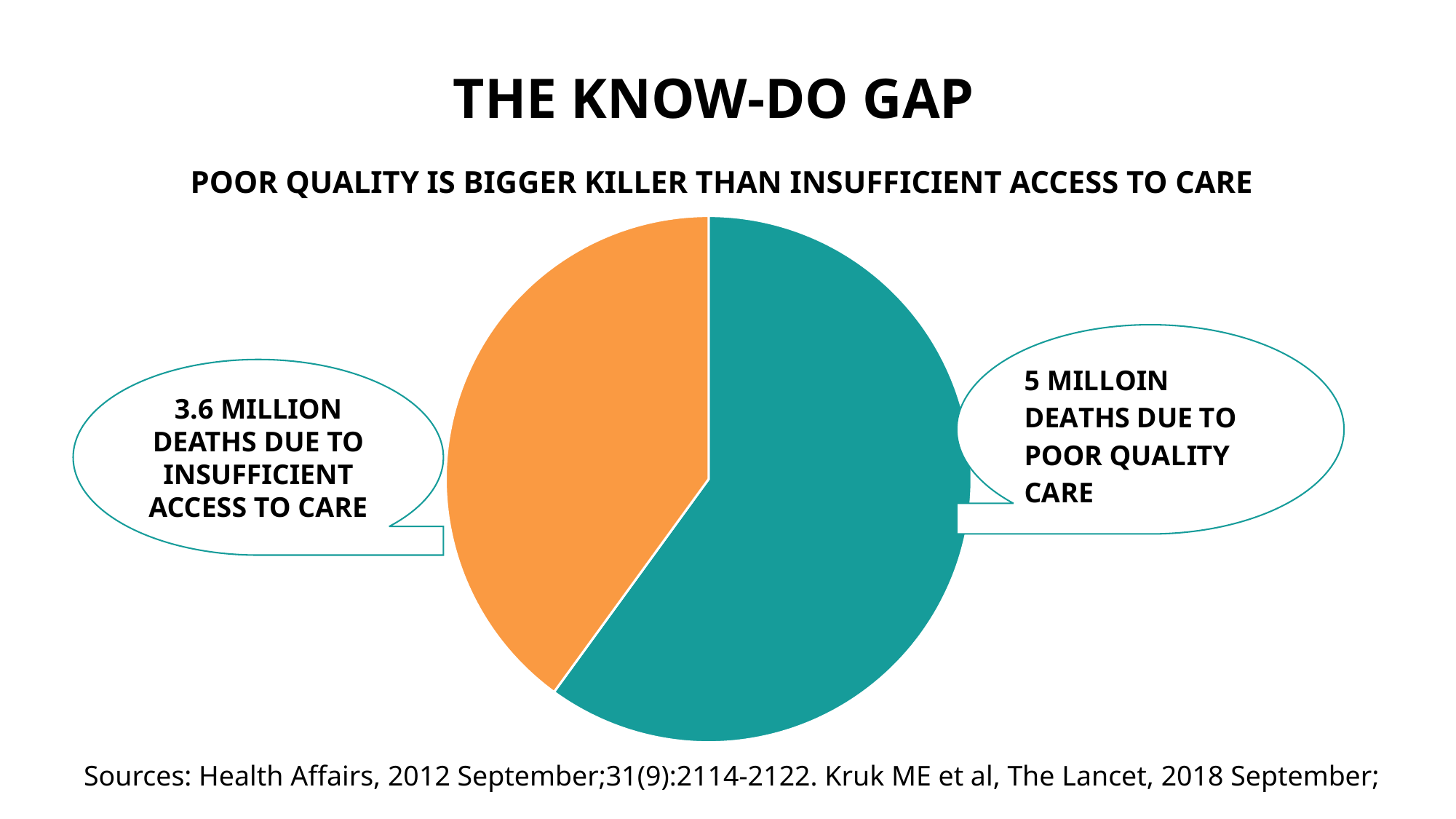
How many slices does the pie chart have? 2 Which cause accounts for the smaller slice of the pie chart? Insufficient access to care How many deaths are attributed to insufficient access to care in the pie chart? 3.6 million What is the total number of deaths represented by the two slices of the pie chart? 8.6 million Which cause accounts for the larger slice of the pie chart? Poor quality care What is the title of the slide containing the pie chart? THE KNOW-DO GAP What is the difference between deaths due to poor quality care and deaths due to insufficient access to care? 1.4 million How many deaths are attributed to poor quality care in the pie chart? 5 million What colour is the slice representing deaths due to poor quality care? Teal What kind of chart is shown on the slide? Pie chart Which is larger: deaths due to poor quality care or deaths due to insufficient access to care? Deaths due to poor quality care